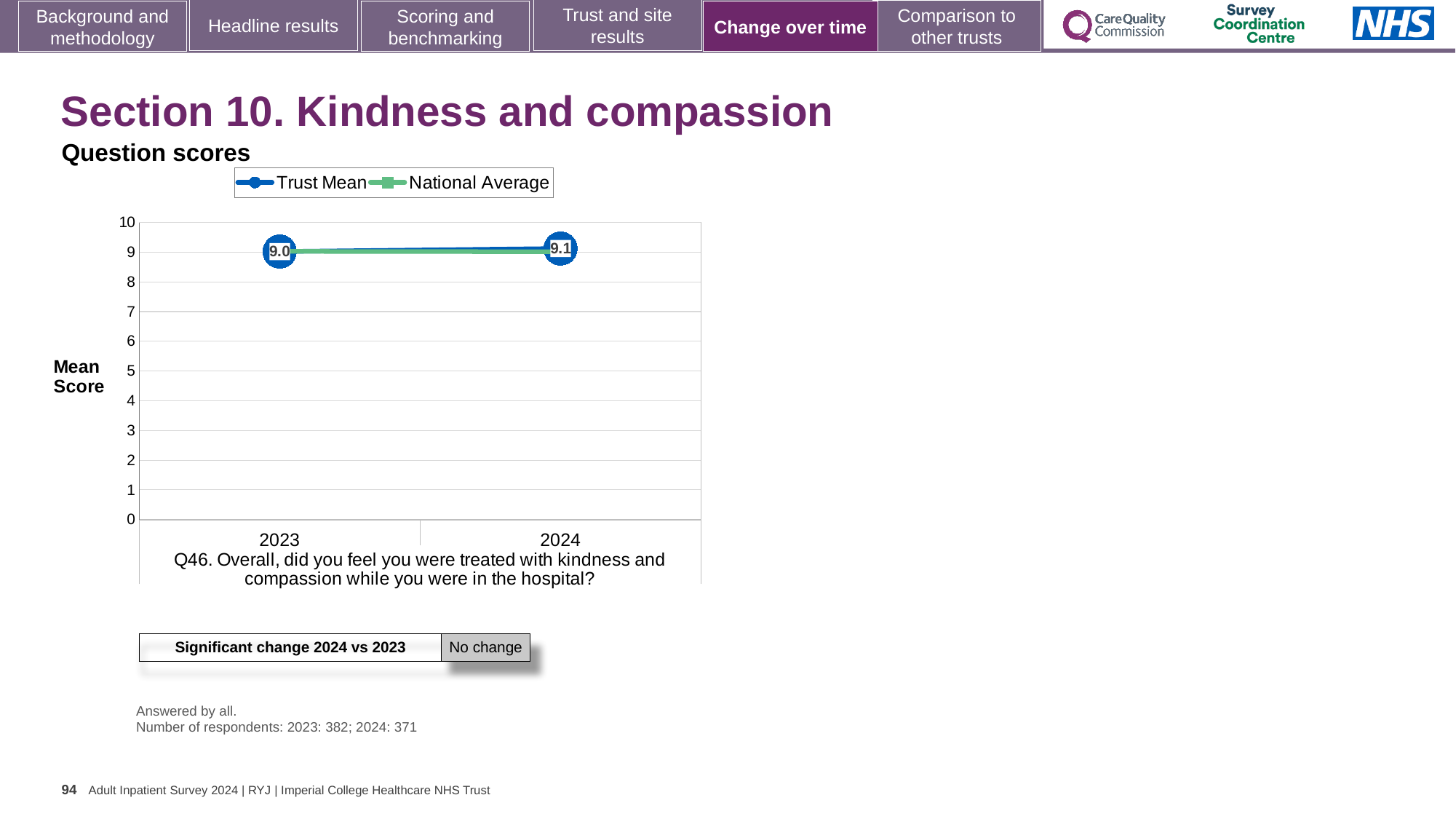
How many years are plotted on the x axis? 2 What is the Trust Mean score for 2023? 9.0 What are the two series named in the legend? Trust Mean and National Average What kind of chart is shown on the slide? line chart Is the National Average value for 2023 greater or less than 8? greater What is the difference between the Trust Mean for 2024 and for 2023? 0.1 Does the Trust Mean rise or fall from 2023 to 2024? rise Which year has the higher Trust Mean, 2023 or 2024? 2024 Is the National Average value for 2024 greater or less than 5? greater What is the Trust Mean score for 2024? 9.1 What is the label on the y axis of the chart? Mean Score How many series does the legend list? 2